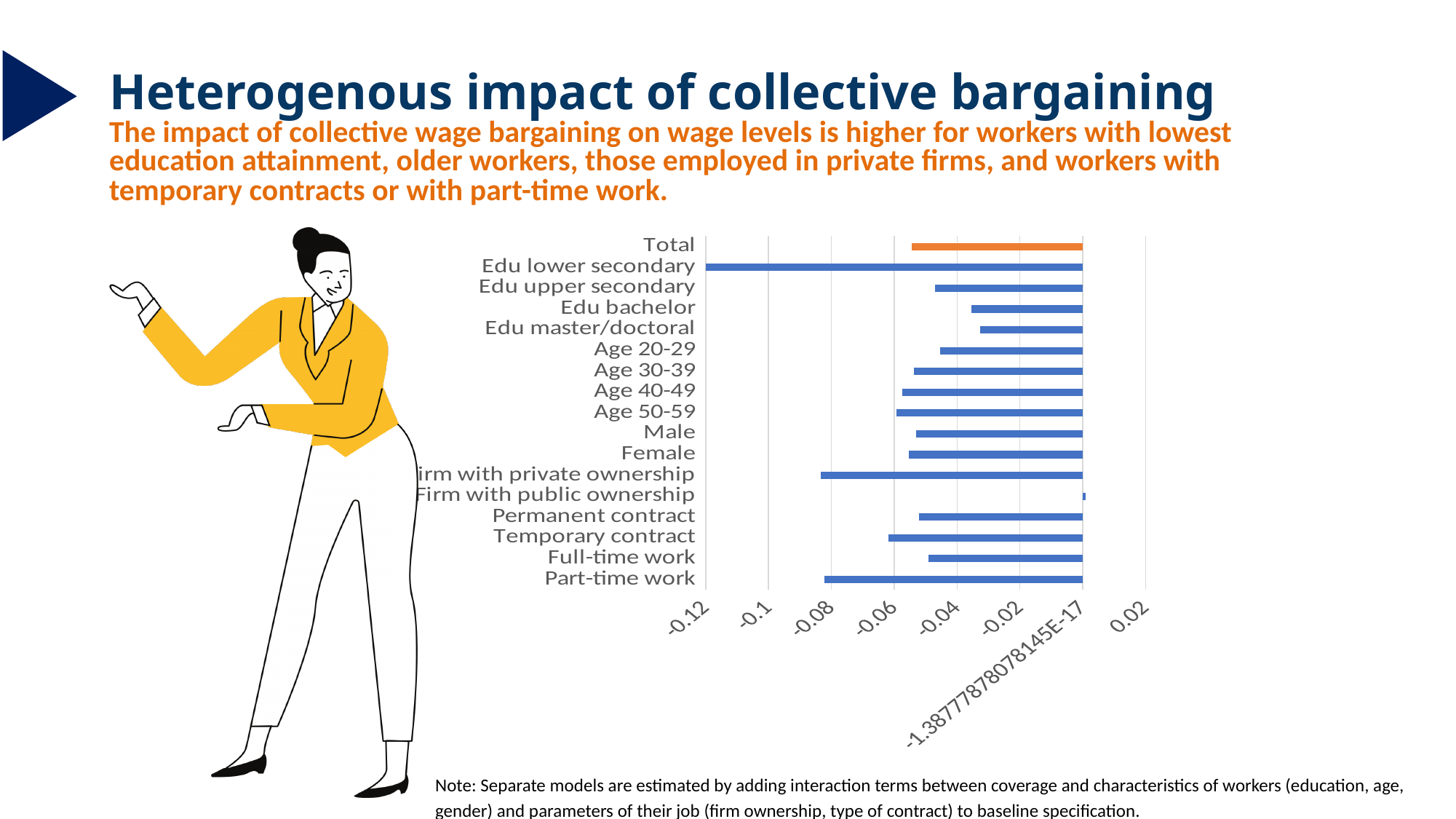
Is the value for Edu lower secondary greater or less than -0.1? less Is the value for Part-time work greater or less than -0.06? less What kind of chart is shown on the slide? bar chart Which has the lower (more negative) value: Temporary contract or Permanent contract? Temporary contract Is the value for Firm with private ownership greater or less than -0.06? less Which category has the lowest (most negative) value in the chart? Edu lower secondary Which category has the highest value in the chart? Firm with public ownership Which bar in the chart is coloured orange rather than blue? Total Which has the lower (more negative) value: Part-time work or Full-time work? Part-time work How many categories are plotted in the bar chart? 17